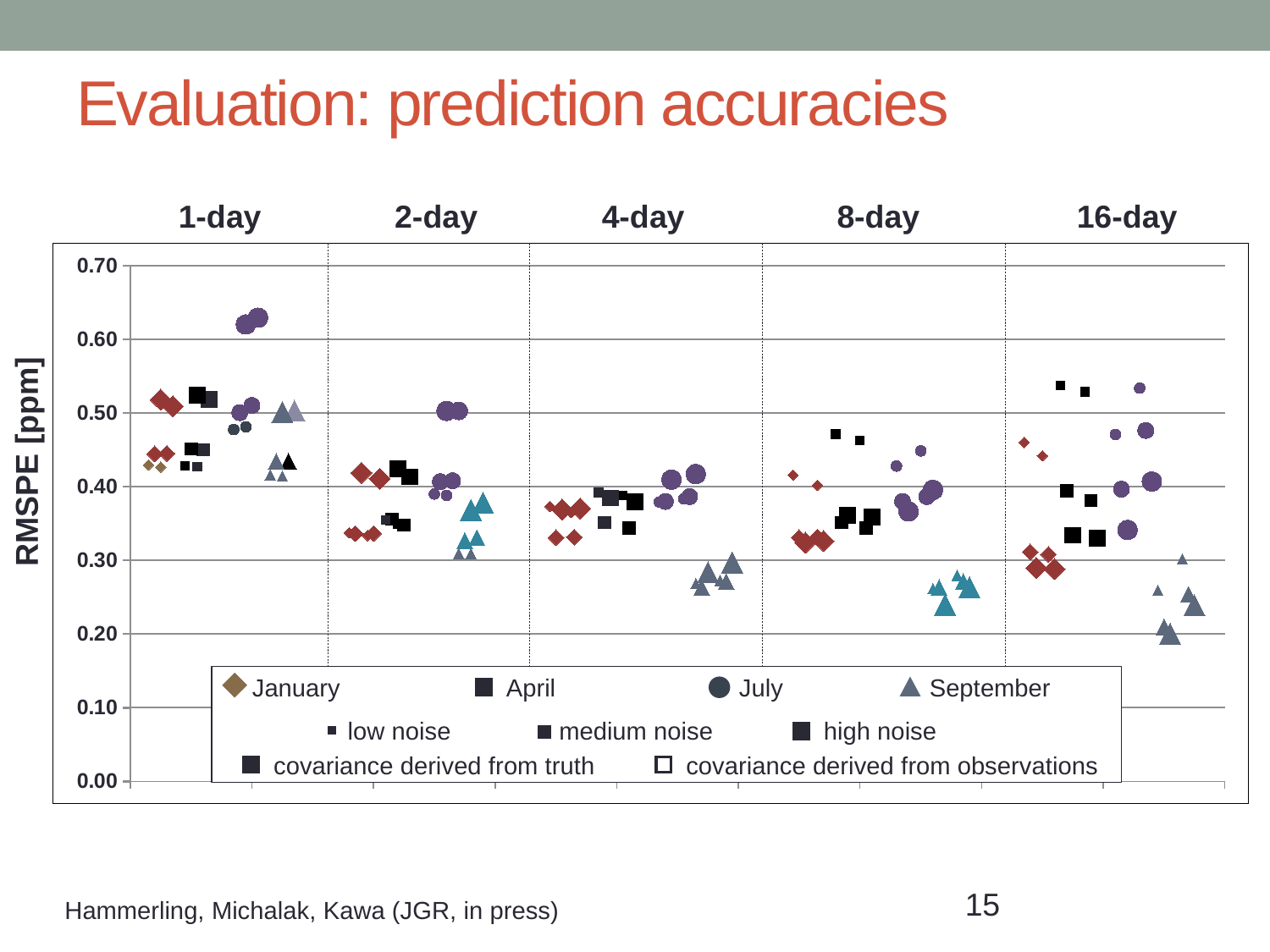
What kind of chart is shown on the slide? scatter chart Are the September values in the 8-day group greater or less than 0.30? less Is the highest July value in the 1-day group greater or less than 0.60? greater Are the January values in the 2-day group greater or less than 0.50? less What is the label of the vertical axis? RMSPE [ppm] Which month has the lowest RMSPE values in the 16-day group? September How many prediction horizons (column groups) are shown along the top of the chart? 5 How many months does the chart legend list? 4 In the 8-day group, which has higher RMSPE values: July or September? July Which months are listed in the legend? January, April, July, September